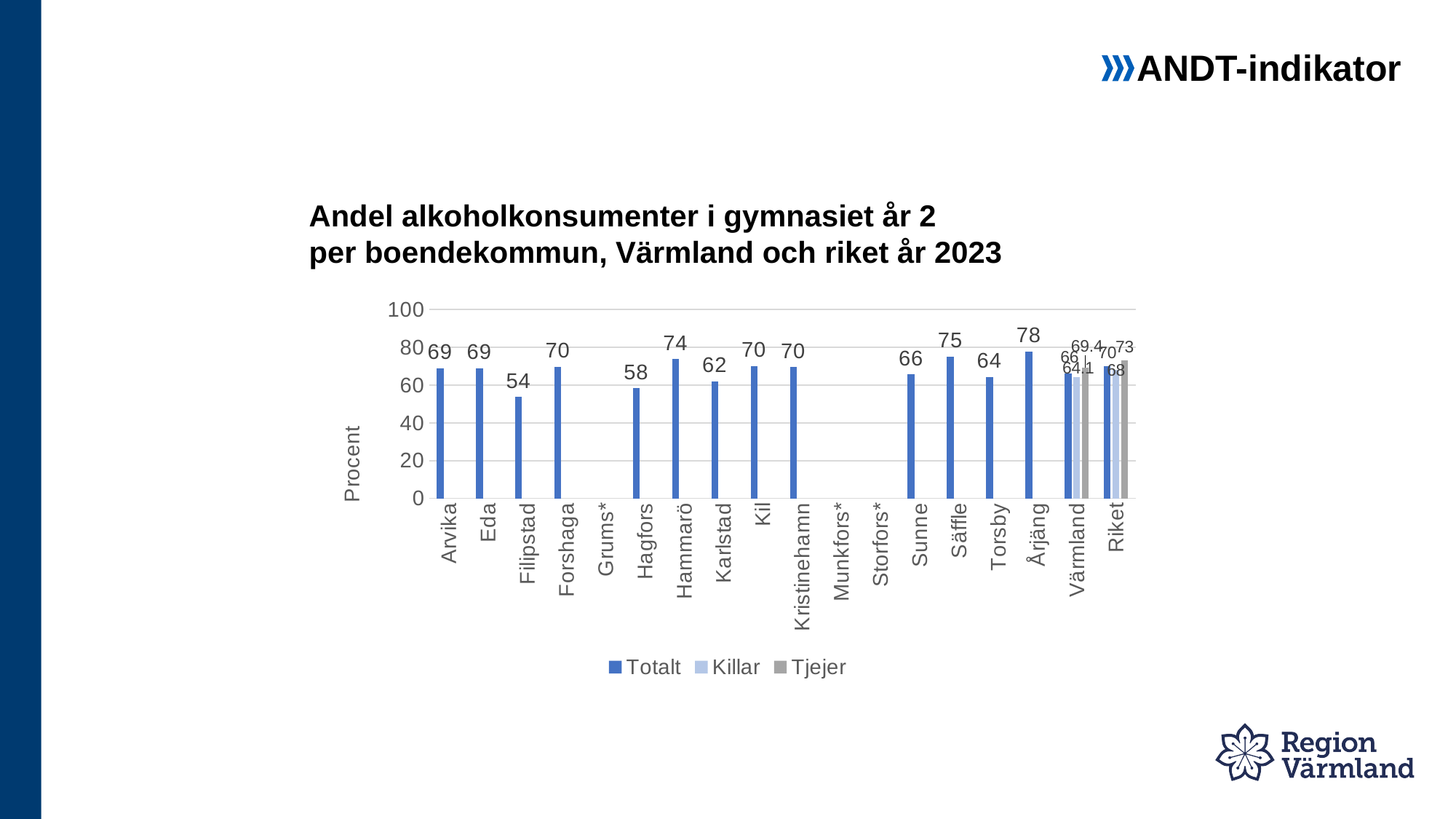
How many series does the legend list? 3 Which municipality has the lowest Totalt value among those with a plotted bar? Filipstad Which municipality has the highest Totalt value? Årjäng What is the Totalt value for Hammarö? 74 What is the Totalt value for Filipstad? 54 Which has a higher Totalt value, Säffle or Sunne? Säffle What is the difference between the Tjejer and Killar values for Riket? 5 What is the Killar value for Värmland? 64.1 What is the label on the vertical axis? Procent What is the difference between the Totalt values for Årjäng and Filipstad? 24 What is the Tjejer value for Riket? 73 What kind of chart is shown on the slide? Bar chart